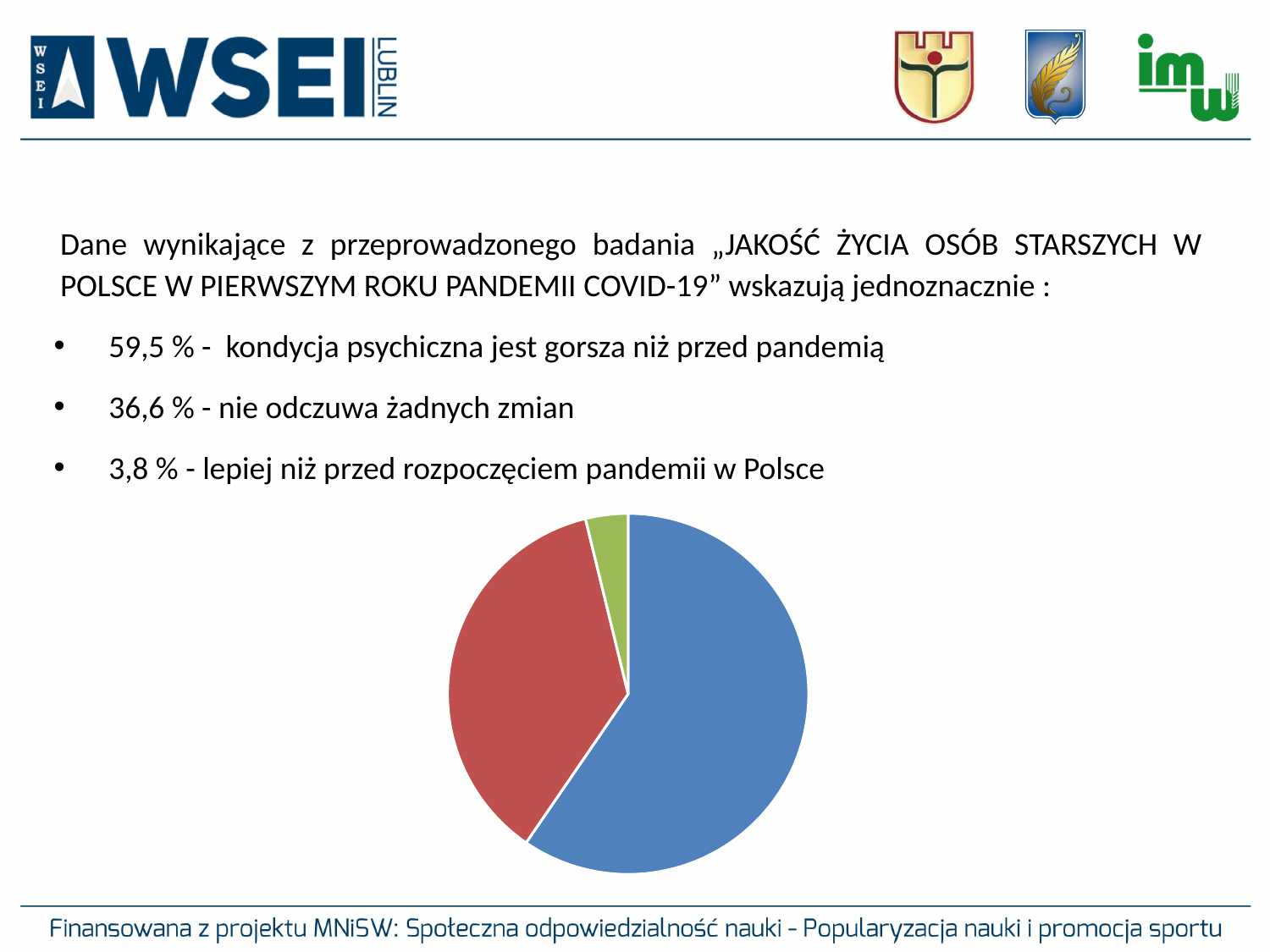
Which slice of the pie chart is larger, the blue one or the red one? blue Which slice of the pie chart is larger, the red one or the green one? red Which colour slice of the pie chart is the smallest? green Does the pie chart display data labels on its slices? No Does the blue slice take up more or less than half of the pie chart? more How many slices does the pie chart have? 3 Does the pie chart have a legend? No What kind of chart is shown on the slide? pie chart Which colour slice of the pie chart is the largest? blue